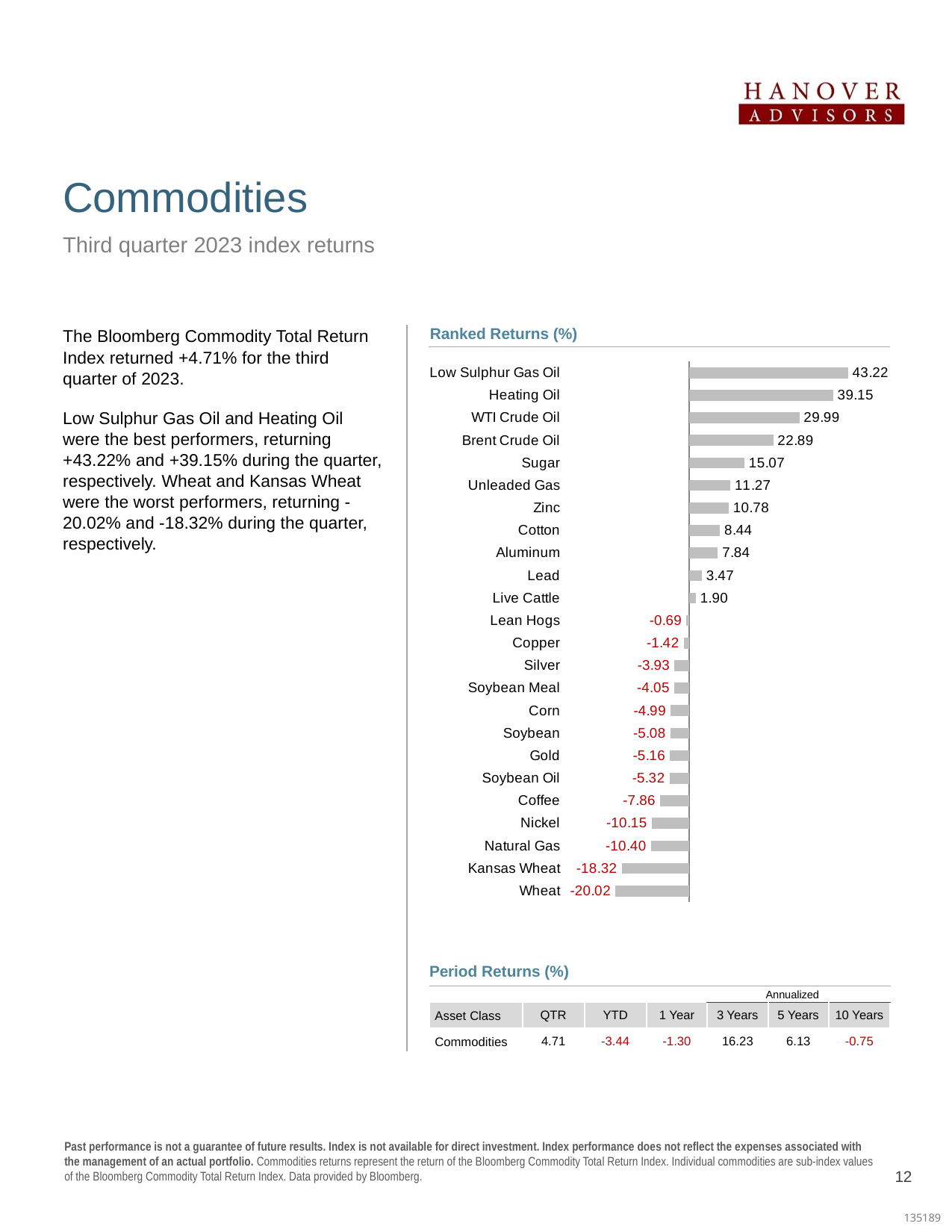
What is the value for WTI Crude Oil in the Ranked Returns (%) chart? 29.99 What is the difference between the values for Low Sulphur Gas Oil and Heating Oil in the Ranked Returns (%) chart? 4.07 Which has a larger value in the Ranked Returns (%) chart, Coffee or Nickel? Coffee How many commodities in the Ranked Returns (%) chart have negative values? 13 What is the value for Live Cattle in the Ranked Returns (%) chart? 1.90 Which commodity has the highest value in the Ranked Returns (%) chart? Low Sulphur Gas Oil What kind of chart is the Ranked Returns (%) chart? Bar chart Which commodity has the lowest value in the Ranked Returns (%) chart? Wheat What is the difference between the values for Sugar and Unleaded Gas in the Ranked Returns (%) chart? 3.80 Which has a larger value in the Ranked Returns (%) chart, Zinc or Cotton? Zinc What is the value for Natural Gas in the Ranked Returns (%) chart? -10.40 How many commodities are shown in the Ranked Returns (%) chart? 24